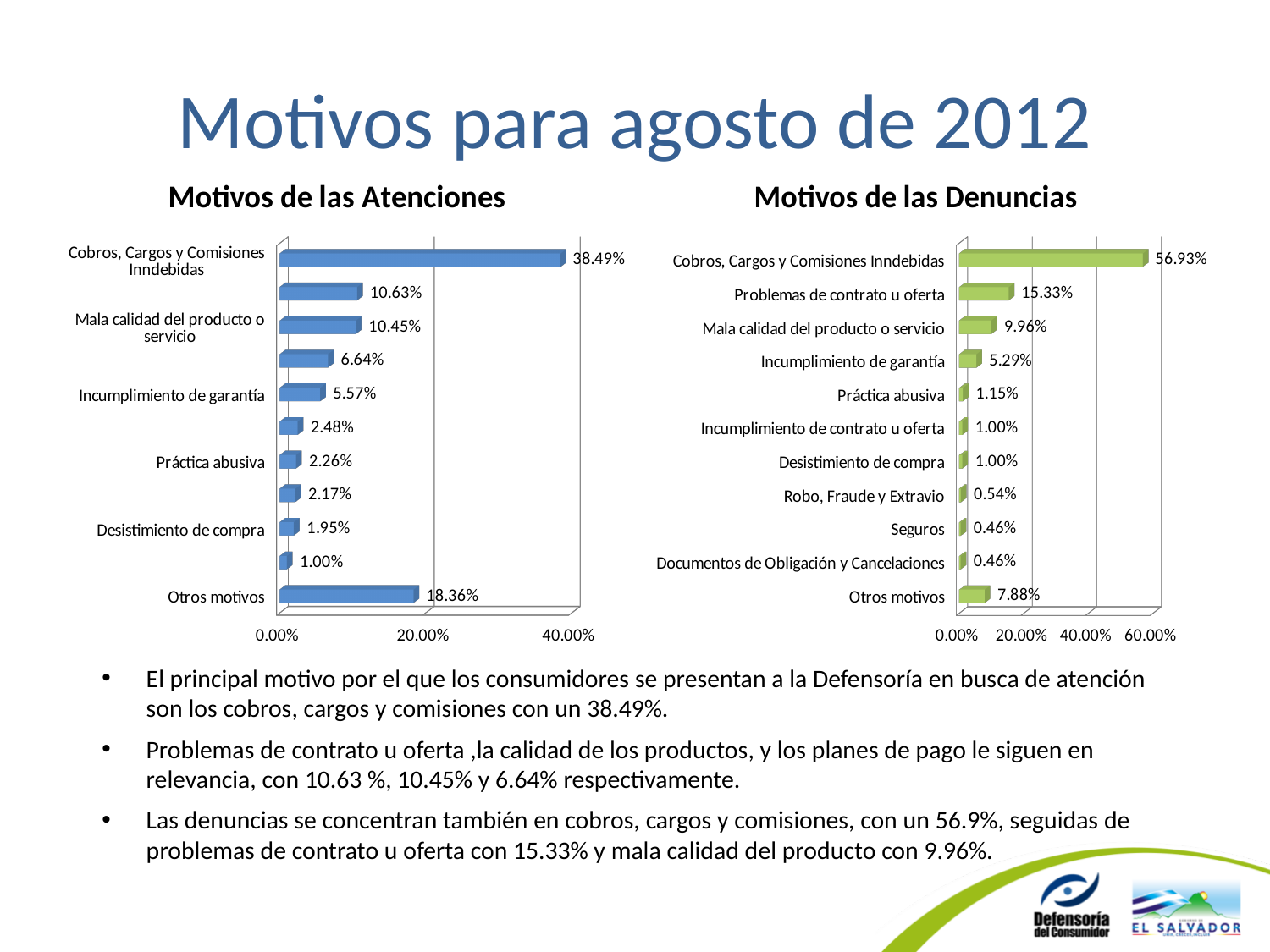
How many bars are plotted in the 'Motivos de las Denuncias' chart? 11 In the 'Motivos de las Denuncias' chart, which category has the highest value? Cobros, Cargos y Comisiones Inndebidas In the 'Motivos de las Atenciones' chart, what is the value for Otros motivos? 18.36% In the 'Motivos de las Atenciones' chart, which is larger: Mala calidad del producto o servicio or Otros motivos? Otros motivos What colour are the bars in the 'Motivos de las Atenciones' chart? Blue In the 'Motivos de las Atenciones' chart, what is the value for Cobros, Cargos y Comisiones Inndebidas? 38.49% In the 'Motivos de las Denuncias' chart, what is the difference between Cobros, Cargos y Comisiones Inndebidas and Problemas de contrato u oferta? 41.60% In the 'Motivos de las Atenciones' chart, what is the value for Incumplimiento de garantía? 5.57% What kind of chart is 'Motivos de las Denuncias'? Bar chart In the 'Motivos de las Denuncias' chart, what is the value for Problemas de contrato u oferta? 15.33% In the 'Motivos de las Atenciones' chart, which labeled category has the lowest value? Desistimiento de compra In the 'Motivos de las Denuncias' chart, what is the value for Otros motivos? 7.88%